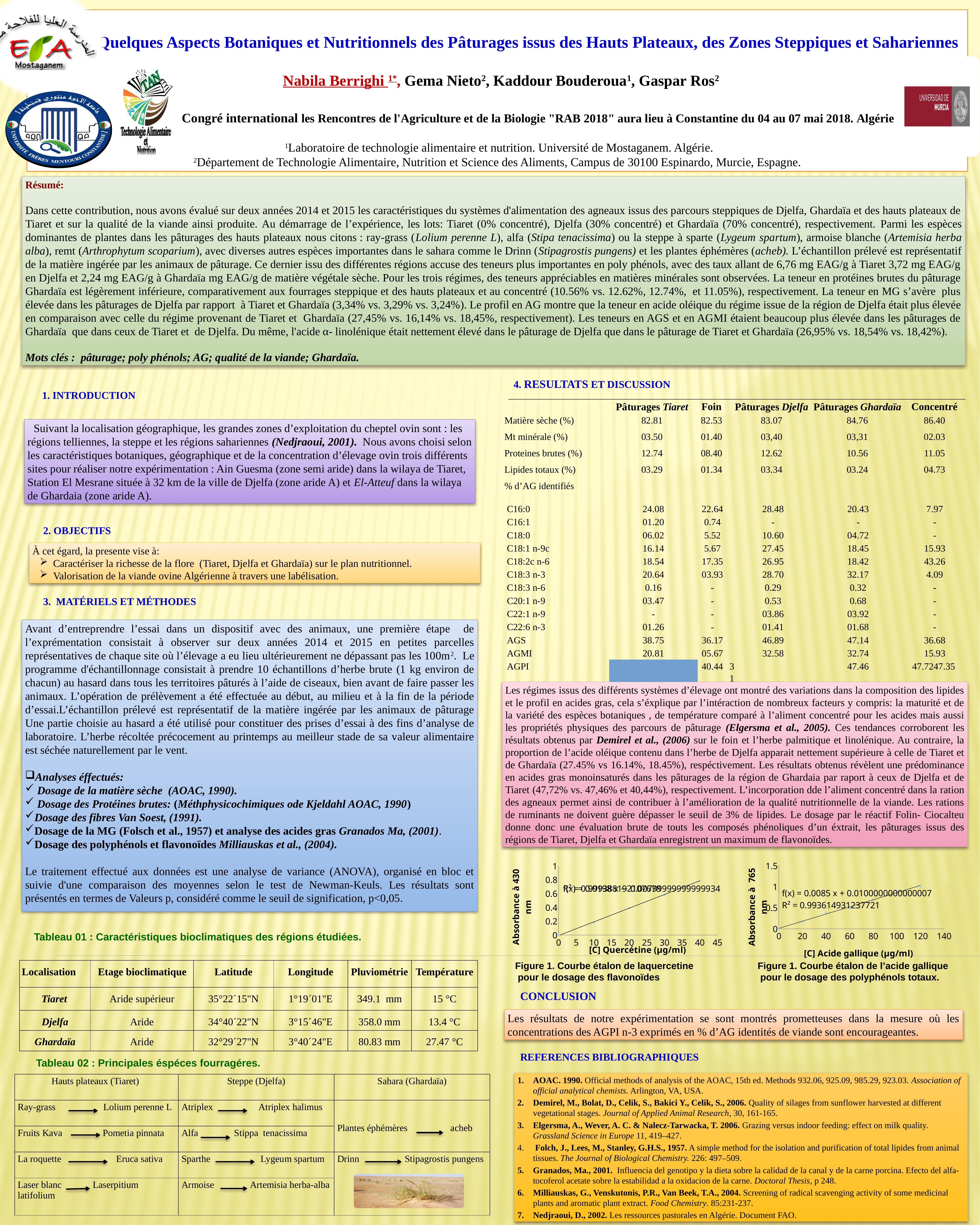
In the chart titled 'Courbe étalon de l'acide gallique', is the absorbance at 40 µg/ml greater or less than 0.5? less In the chart titled 'Courbe étalon de laquercetine', is the absorbance at 20 µg/ml greater or less than 0.6? less In the chart titled 'Courbe étalon de laquercetine', does the absorbance rise or fall as the quercetin concentration increases? rise In the chart titled 'Courbe étalon de l'acide gallique', what R² value is printed on the chart? 0.993614931237721 In the chart titled 'Courbe étalon de l'acide gallique', what is the slope of the fitted line f(x) shown on the chart? 0.0085 In the chart titled 'Courbe étalon de l'acide gallique', what is the highest value shown on the y axis? 1.5 In the chart titled 'Courbe étalon de l'acide gallique', what is the label of the x axis? [C] Acide gallique (µg/ml) In the chart titled 'Courbe étalon de laquercetine', what is the highest value shown on the x axis? 45 In the chart titled 'Courbe étalon de l'acide gallique', does the absorbance rise or fall as the gallic acid concentration increases? rise